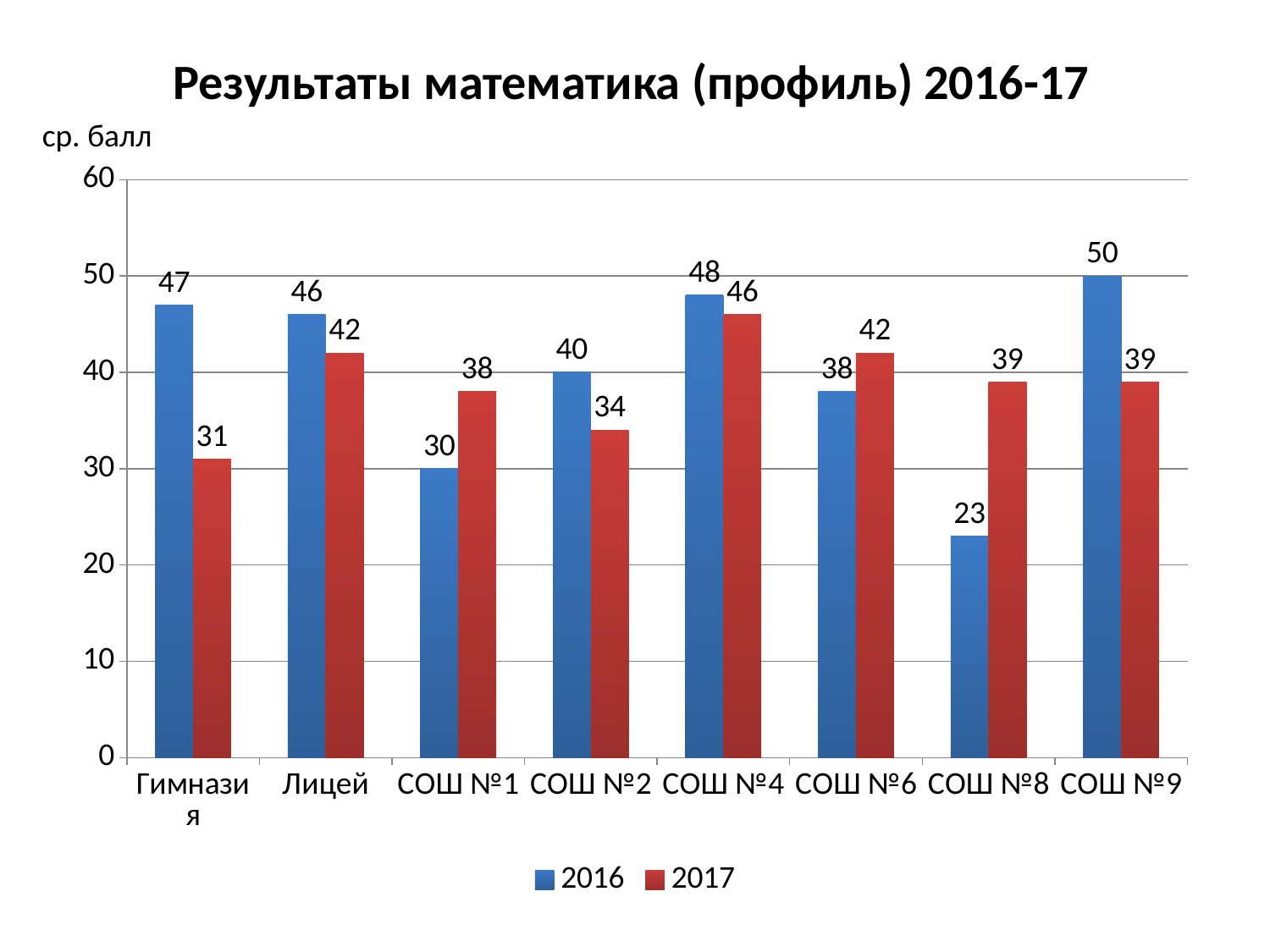
What is the 2017 value for СОШ №4? 46 What is the 2017 value for СОШ №8? 39 Which is larger for Лицей: the 2016 value or the 2017 value? 2016 How many categories are shown on the x axis? 8 Which category has the lowest 2017 value? Гимназия What is the 2016 value for Гимназия? 47 What is the difference between the 2017 and 2016 values for СОШ №8? 16 What is the title of the chart? Результаты математика (профиль) 2016-17 What kind of chart is shown on the slide? bar chart Which category has the highest 2016 value? СОШ №9 How many series does the legend list? 2 What is the difference between the 2016 and 2017 values for Гимназия? 16